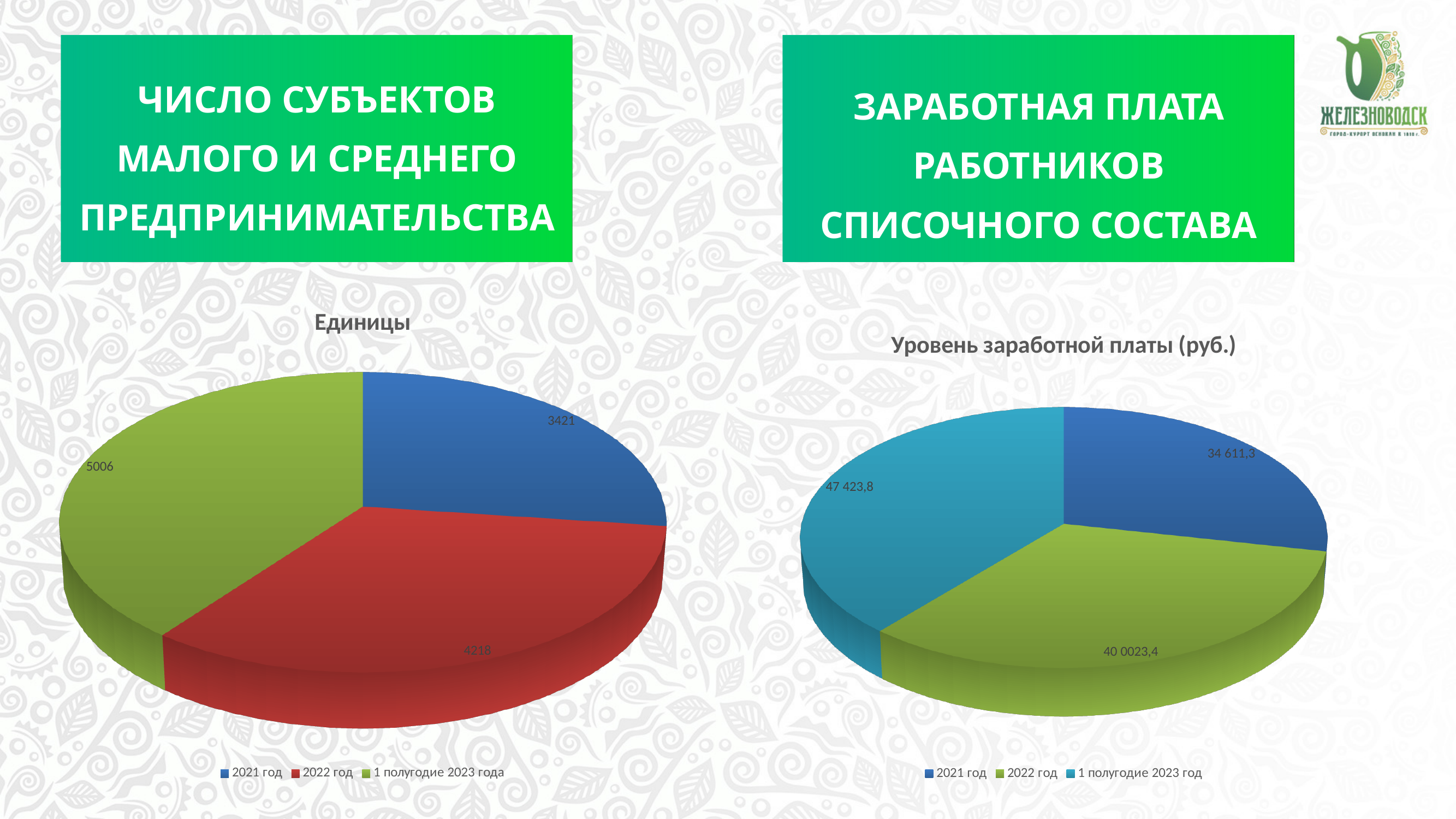
In the left chart "Единицы", which category has the largest slice? 1 полугодие 2023 года In the right chart "Уровень заработной платы (руб.)", what is the value for 2021 год? 34 611,3 How many slices does the right chart "Уровень заработной платы (руб.)" have? 3 In the right chart "Уровень заработной платы (руб.)", what colour is the slice for 2022 год? green What type of chart is the left chart titled "Единицы"? pie chart In the left chart "Единицы", which category has the smallest slice? 2021 год In the left chart "Единицы", what is the value for 2021 год? 3421 In the left chart "Единицы", what is the value for 2022 год? 4218 In the left chart "Единицы", what is the value for 1 полугодие 2023 года? 5006 In the right chart "Уровень заработной платы (руб.)", what is the value for 1 полугодие 2023 год? 47 423,8 In the right chart "Уровень заработной платы (руб.)", which is larger: the value for 2021 год or the value for 1 полугодие 2023 год? 1 полугодие 2023 год In the left chart "Единицы", what is the difference between the values for 1 полугодие 2023 года and 2021 год? 1585